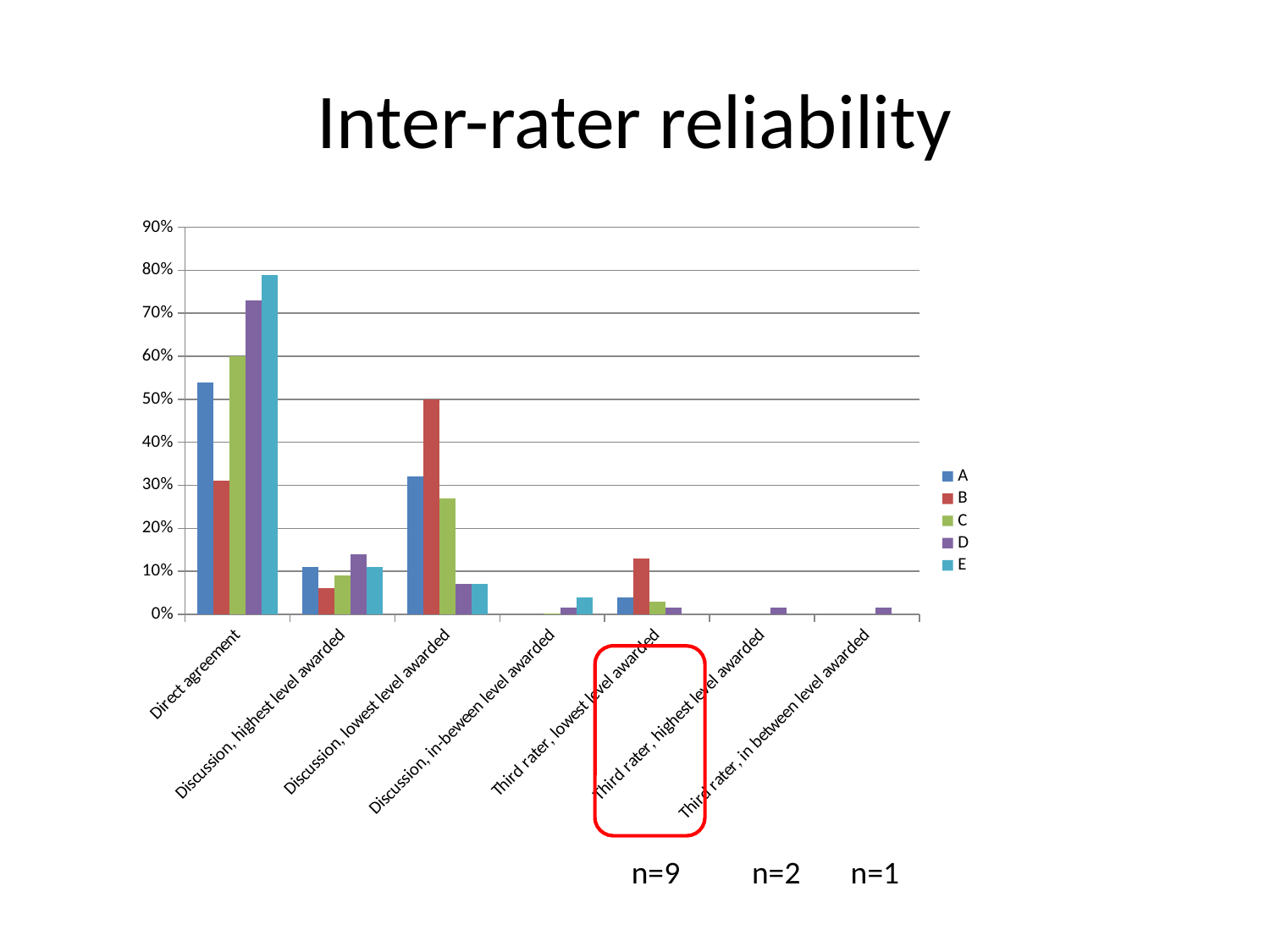
Which series is shown in red in the legend? B Is the value for series E in the Direct agreement category greater or less than 70%? greater How many categories are shown on the x axis? 7 In the Direct agreement category, which series has the lowest value? B How many series does the legend list? 5 In the Discussion, lowest level awarded category, which series has the highest value? B In the Discussion, lowest level awarded category, which is larger: series A or series B? B Is the value for series B in the Discussion, lowest level awarded category greater or less than 40%? greater Is the value for series B in the Direct agreement category greater or less than 40%? less What is the title of the slide? Inter-rater reliability In the Direct agreement category, which series has the highest value? E What kind of chart is shown on the slide? bar chart